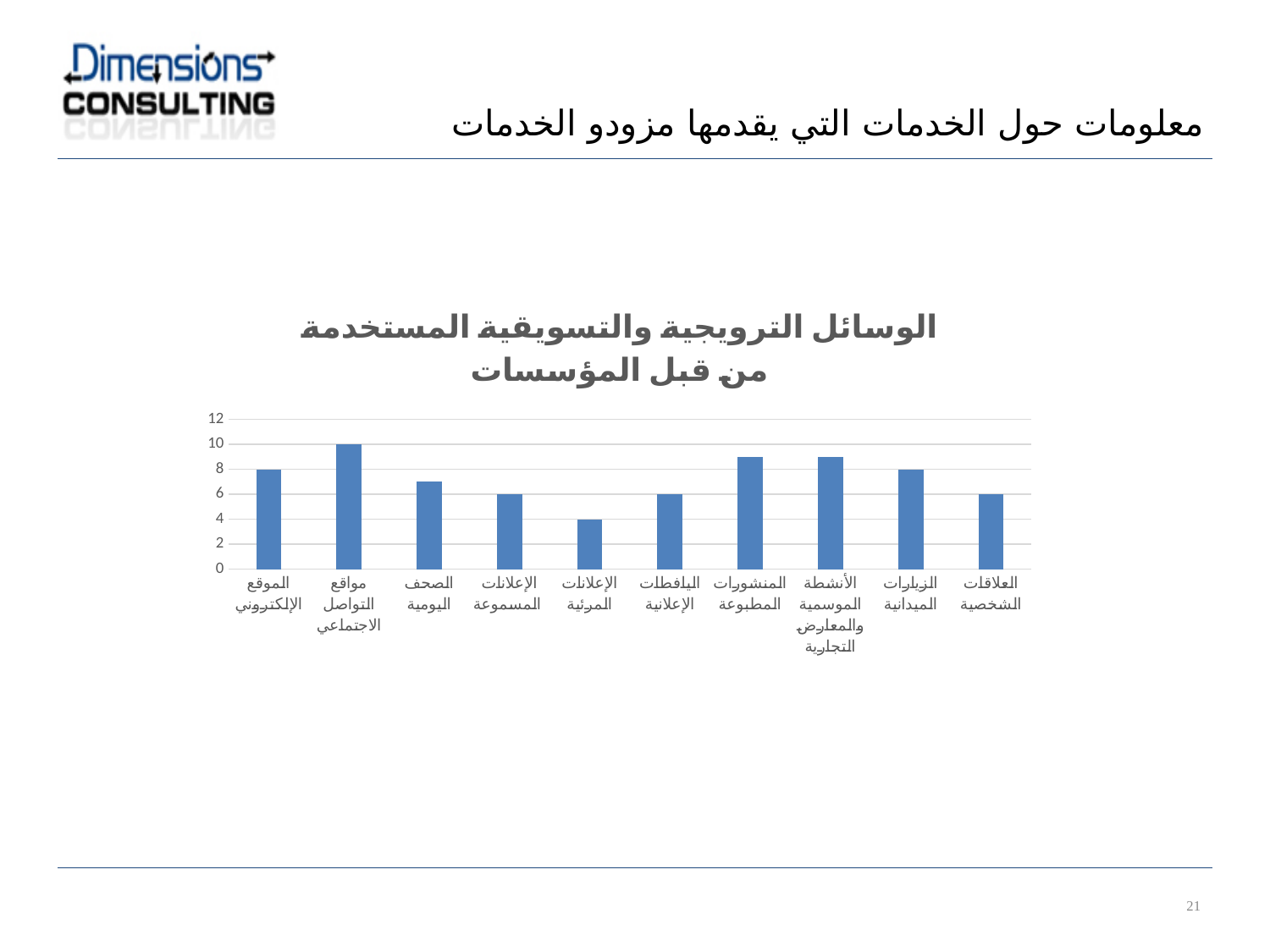
What is the value for الإعلانات المرئية? 4 Which category has the lowest value in the chart? الإعلانات المرئية Which category has the highest value in the chart? مواقع التواصل الاجتماعي What is the title of the chart? الوسائل الترويجية والتسويقية المستخدمة من قبل المؤسسات Which is larger, the value for الموقع الإلكتروني or the value for الإعلانات المرئية? الموقع الإلكتروني What type of chart is shown on the slide? Bar chart What is the value for مواقع التواصل الاجتماعي? 10 What is the difference between the values for مواقع التواصل الاجتماعي and الإعلانات المرئية? 6 Is the value for المنشورات المطبوعة greater or less than 8? greater What is the value for الموقع الإلكتروني? 8 What is the value for العلاقات الشخصية? 6 How many categories are shown on the x axis of the chart? 10